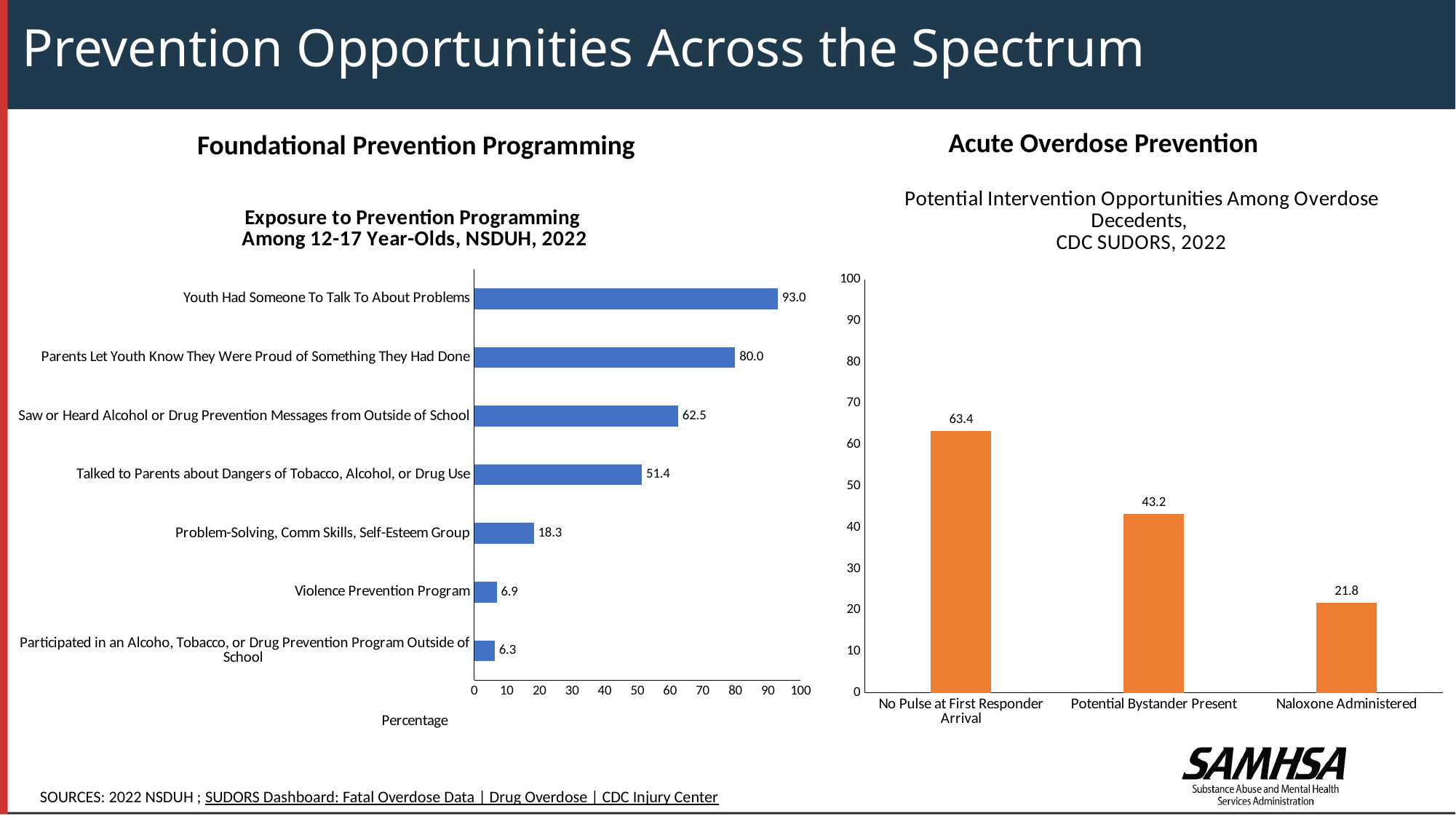
In the 'Exposure to Prevention Programming Among 12-17 Year-Olds' chart, what is the value for 'Violence Prevention Program'? 6.9 In the 'Exposure to Prevention Programming Among 12-17 Year-Olds' chart, what is the value for 'Youth Had Someone To Talk To About Problems'? 93.0 In the 'Exposure to Prevention Programming Among 12-17 Year-Olds' chart, which is larger: 'Talked to Parents about Dangers of Tobacco, Alcohol, or Drug Use' or 'Problem-Solving, Comm Skills, Self-Esteem Group'? Talked to Parents about Dangers of Tobacco, Alcohol, or Drug Use In the 'Exposure to Prevention Programming Among 12-17 Year-Olds' chart, how many categories are shown? 7 What is the x-axis label of the 'Exposure to Prevention Programming Among 12-17 Year-Olds' chart? Percentage What kind of chart is the 'Exposure to Prevention Programming Among 12-17 Year-Olds' chart? Bar chart In the 'Potential Intervention Opportunities Among Overdose Decedents' chart, how many categories are shown? 3 In the 'Exposure to Prevention Programming Among 12-17 Year-Olds' chart, what is the difference between 'Parents Let Youth Know They Were Proud of Something They Had Done' and 'Saw or Heard Alcohol or Drug Prevention Messages from Outside of School'? 17.5 In the 'Potential Intervention Opportunities Among Overdose Decedents' chart, which category has the highest value? No Pulse at First Responder Arrival In the 'Exposure to Prevention Programming Among 12-17 Year-Olds' chart, which category has the lowest value? Participated in an Alcoho, Tobacco, or Drug Prevention Program Outside of School In the 'Potential Intervention Opportunities Among Overdose Decedents' chart, what is the value for 'Naloxone Administered'? 21.8 In the 'Potential Intervention Opportunities Among Overdose Decedents' chart, what is the difference between 'No Pulse at First Responder Arrival' and 'Potential Bystander Present'? 20.2